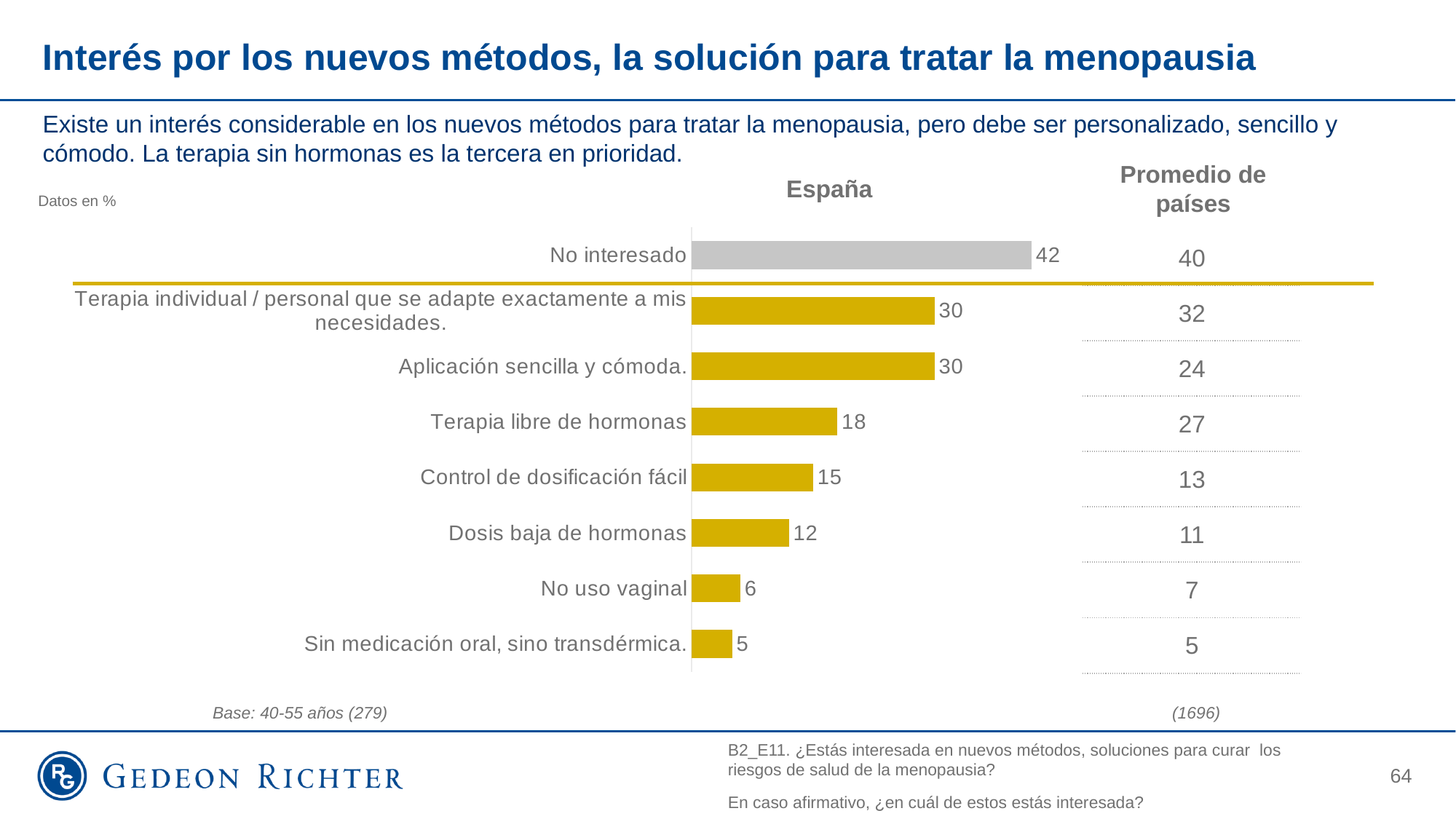
What is the value for "No interesado" in the España bar chart? 42 In the España bar chart, which is larger: "Control de dosificación fácil" or "Dosis baja de hormonas"? Control de dosificación fácil What is the value for "Terapia libre de hormonas" in the España bar chart? 18 In the España bar chart, what is the difference between "No interesado" and "Dosis baja de hormonas"? 30 What is the value for "Control de dosificación fácil" in the España bar chart? 15 In the España bar chart, what is the difference between "Terapia libre de hormonas" and "No uso vaginal"? 12 What is the value for "Sin medicación oral, sino transdérmica." in the España bar chart? 5 Which category has the lowest value in the España bar chart? Sin medicación oral, sino transdérmica. What colour is the bar for "No interesado" in the España chart? Grey What type of chart is used to show the España data? Bar chart How many categories are shown in the España bar chart? 8 Which category has the highest value in the España bar chart? No interesado